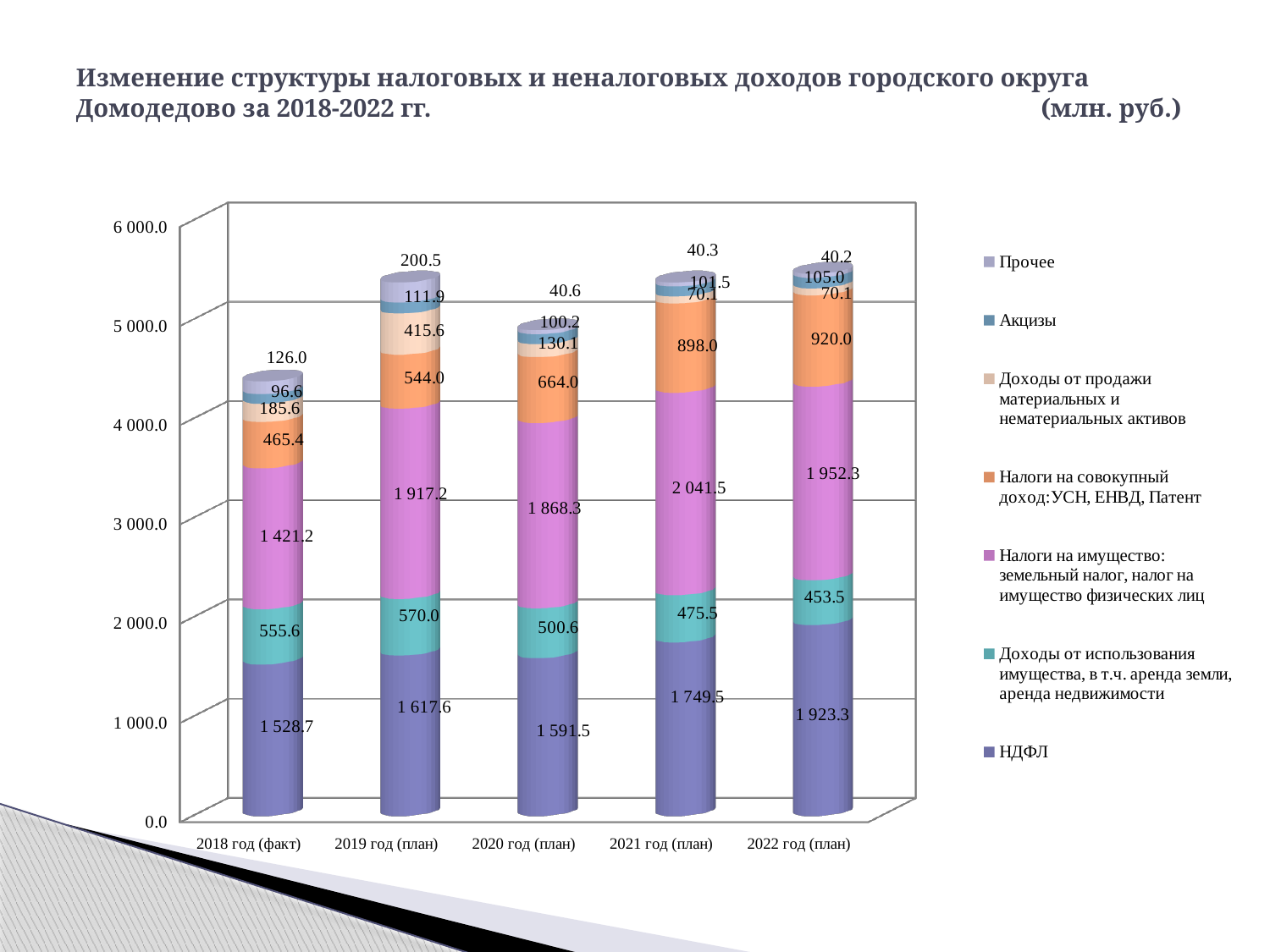
What is the value of Налоги на совокупный доход: УСН, ЕНВД, Патент for 2020 год (план)? 664.0 How many year categories are shown on the x axis? 5 What is the total of the stacked bar for 2022 год (план)? 5 464.4 How many series does the legend list? 7 Is the total height of the 2018 год (факт) bar greater or less than 5 000.0? less In which year is the Налоги на совокупный доход: УСН, ЕНВД, Патент value the lowest? 2018 год (факт) Which is larger: Доходы от использования имущества in 2019 год (план) or in 2022 год (план)? 2019 год (план) What is the value of Прочее for 2019 год (план)? 200.5 What is the difference between the Налоги на имущество values for 2021 год (план) and 2018 год (факт)? 620.3 What kind of chart is shown on the slide? stacked bar chart In which year is the НДФЛ value the highest? 2022 год (план) What is the value of НДФЛ for 2022 год (план)? 1 923.3